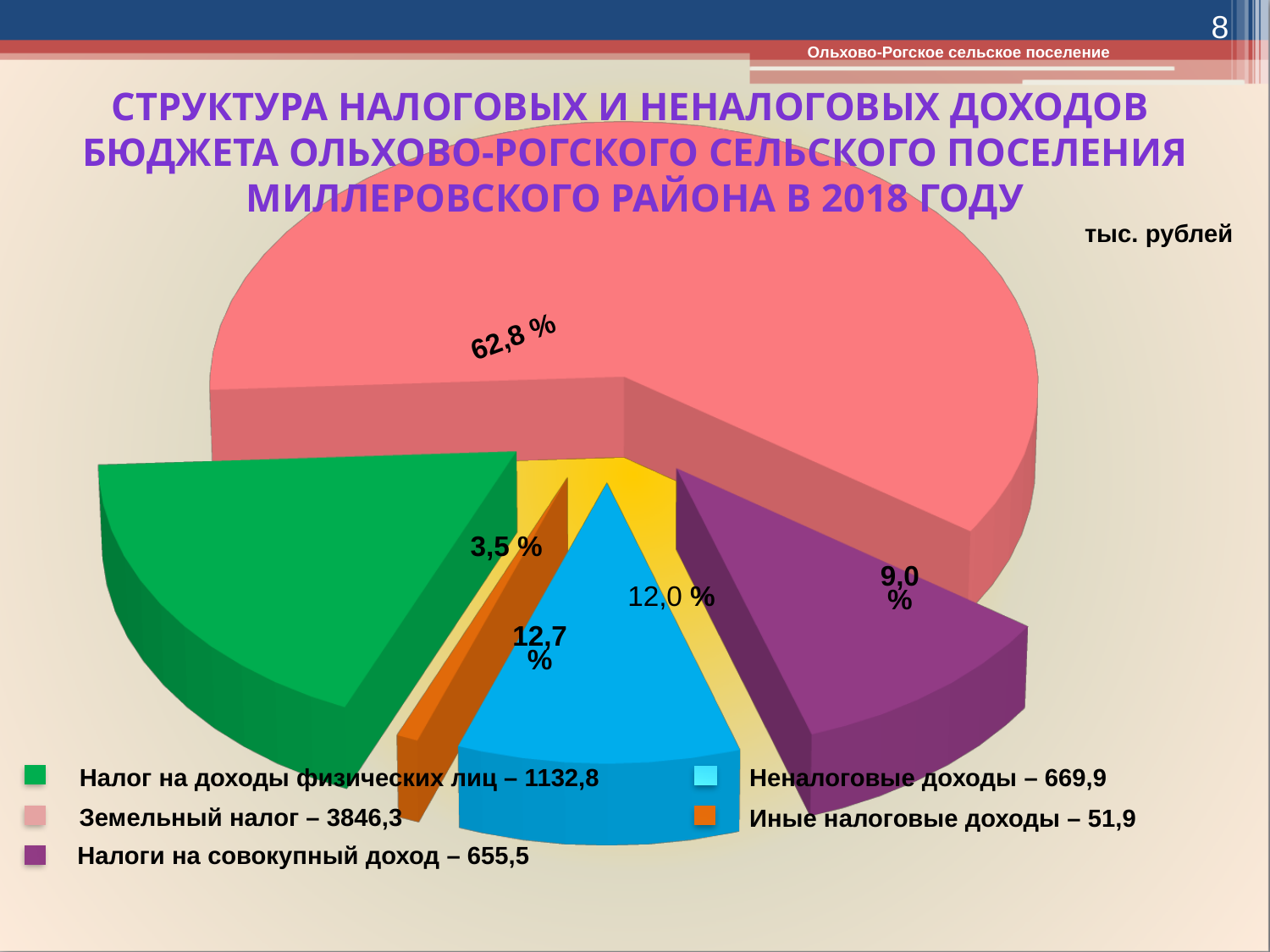
What is the value shown for Иные налоговые доходы? 51,9 What is the value shown for Земельный налог? 3846,3 What kind of chart is shown on the slide? Pie chart What is the difference between the values for Земельный налог and Налог на доходы физических лиц? 2713,5 What is the value shown for Налог на доходы физических лиц? 1132,8 Which is larger: Неналоговые доходы or Налоги на совокупный доход? Неналоговые доходы What colour is the slice for Земельный налог? Pink In what units are the values on the slide given? тыс. рублей What percentage label is shown on the largest (pink) slice of the pie? 62,8 % Which category has the smallest value? Иные налоговые доходы How many categories does the pie chart's legend list? 5 Which category has the largest value? Земельный налог